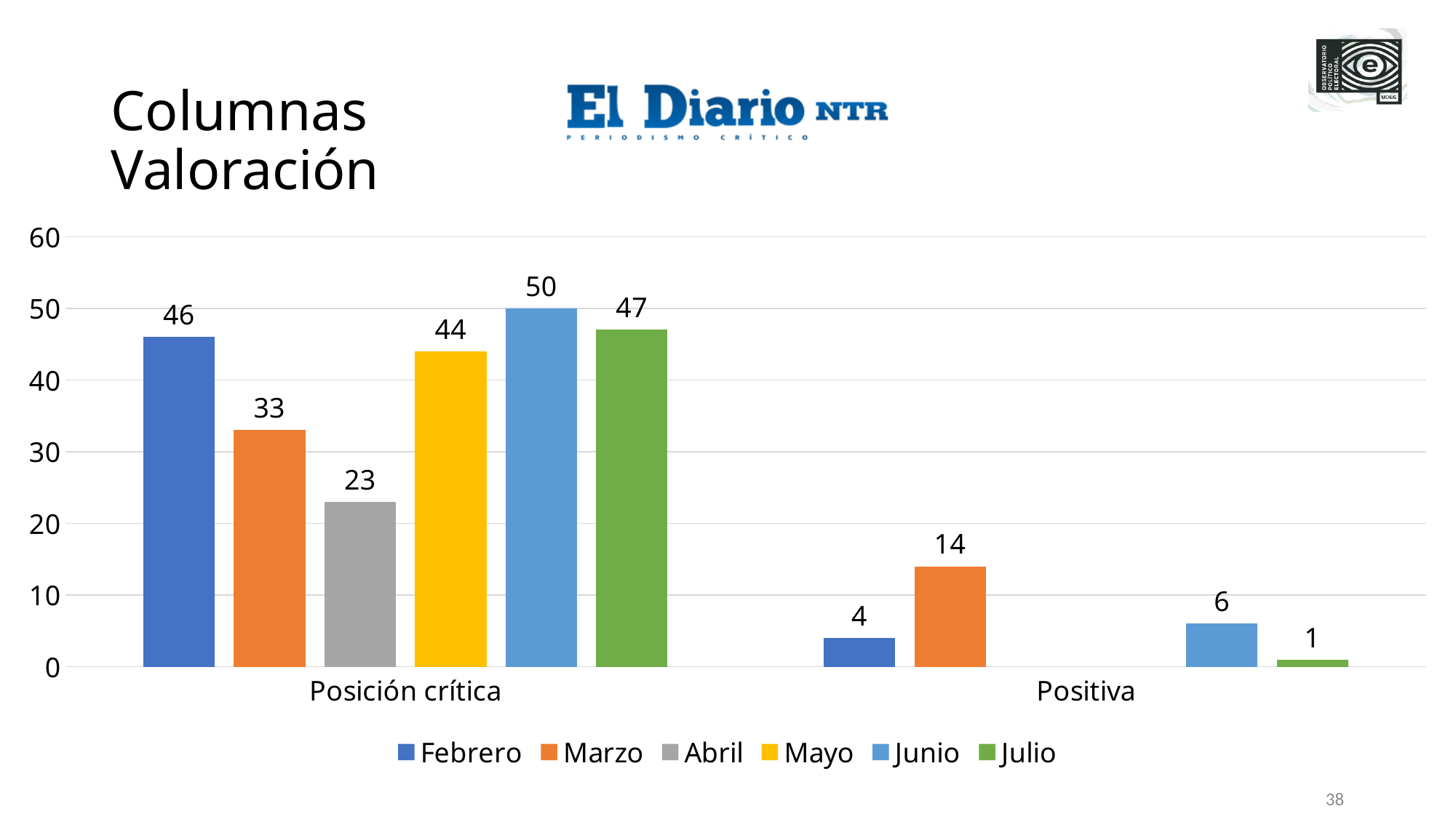
Which is larger in the Posición crítica category, Mayo or Julio? Julio How many series does the legend list? 6 What is the value for Abril in the Posición crítica category? 23 How many categories are shown on the x axis? 2 What is the title of the slide? Columnas Valoración What is the value for Marzo in the Positiva category? 14 What is the difference between the Febrero and Marzo values in the Posición crítica category? 13 What kind of chart is shown on the slide? Bar chart What is the value for Junio in the Posición crítica category? 50 Which month has the highest value in the Posición crítica category? Junio Is the value for Febrero in the Posición crítica category greater or less than 40? greater Which month has the lowest value in the Positiva category? Julio